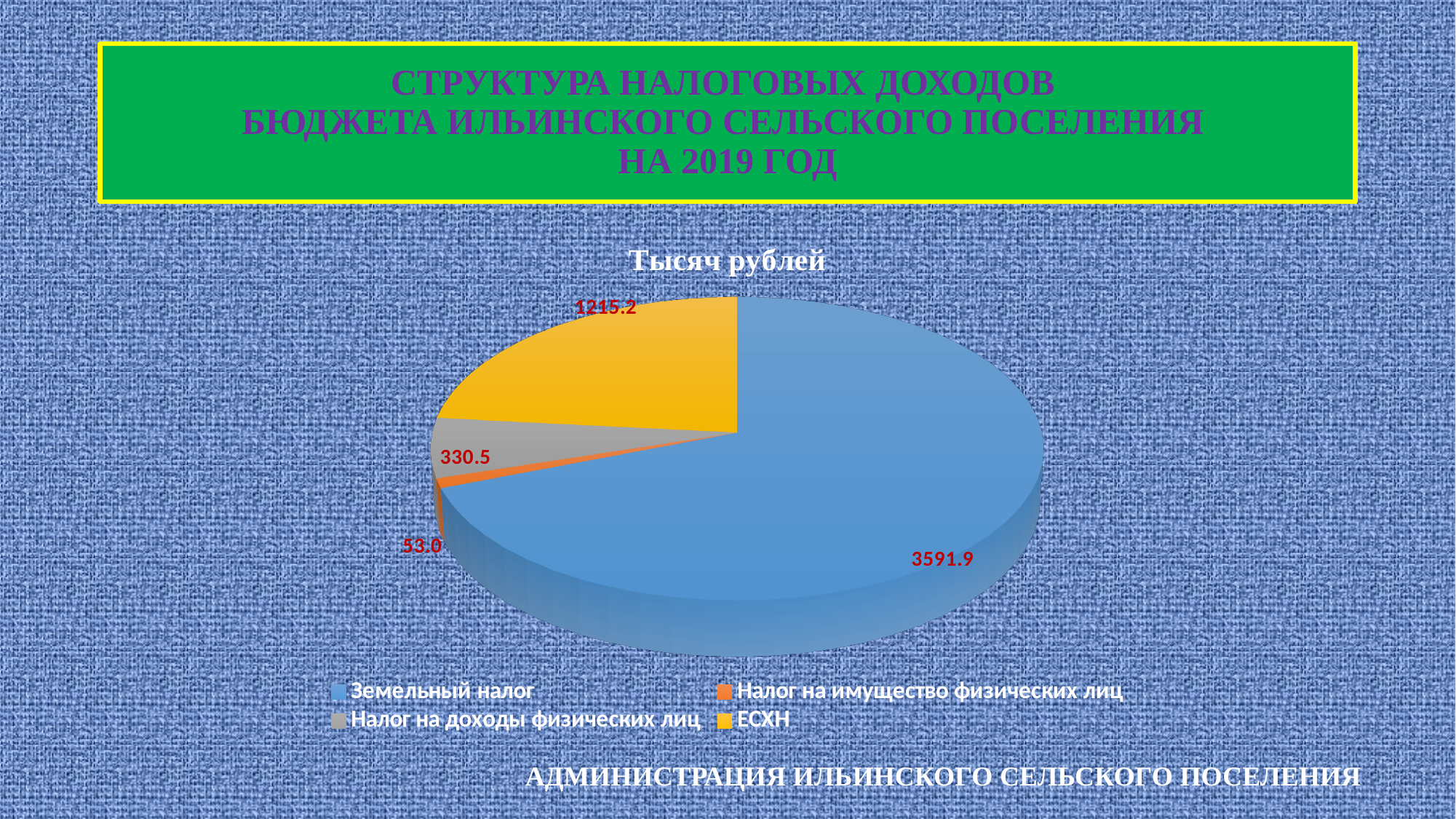
What is the value for ЕСХН? 1215.2 What is the title of the chart? Тысяч рублей What type of chart is shown on the slide? pie chart What is the difference between the values for Земельный налог and ЕСХН? 2376.7 What colour is the slice for ЕСХН? yellow What is the value for Земельный налог? 3591.9 What is the value for Налог на доходы физических лиц? 330.5 Which category has the smallest slice of the pie? Налог на имущество физических лиц What is the value for Налог на имущество физических лиц? 53.0 Which is larger: the value for ЕСХН or the value for Налог на доходы физических лиц? ЕСХН How many categories does the pie chart show? 4 Which category has the largest slice of the pie? Земельный налог